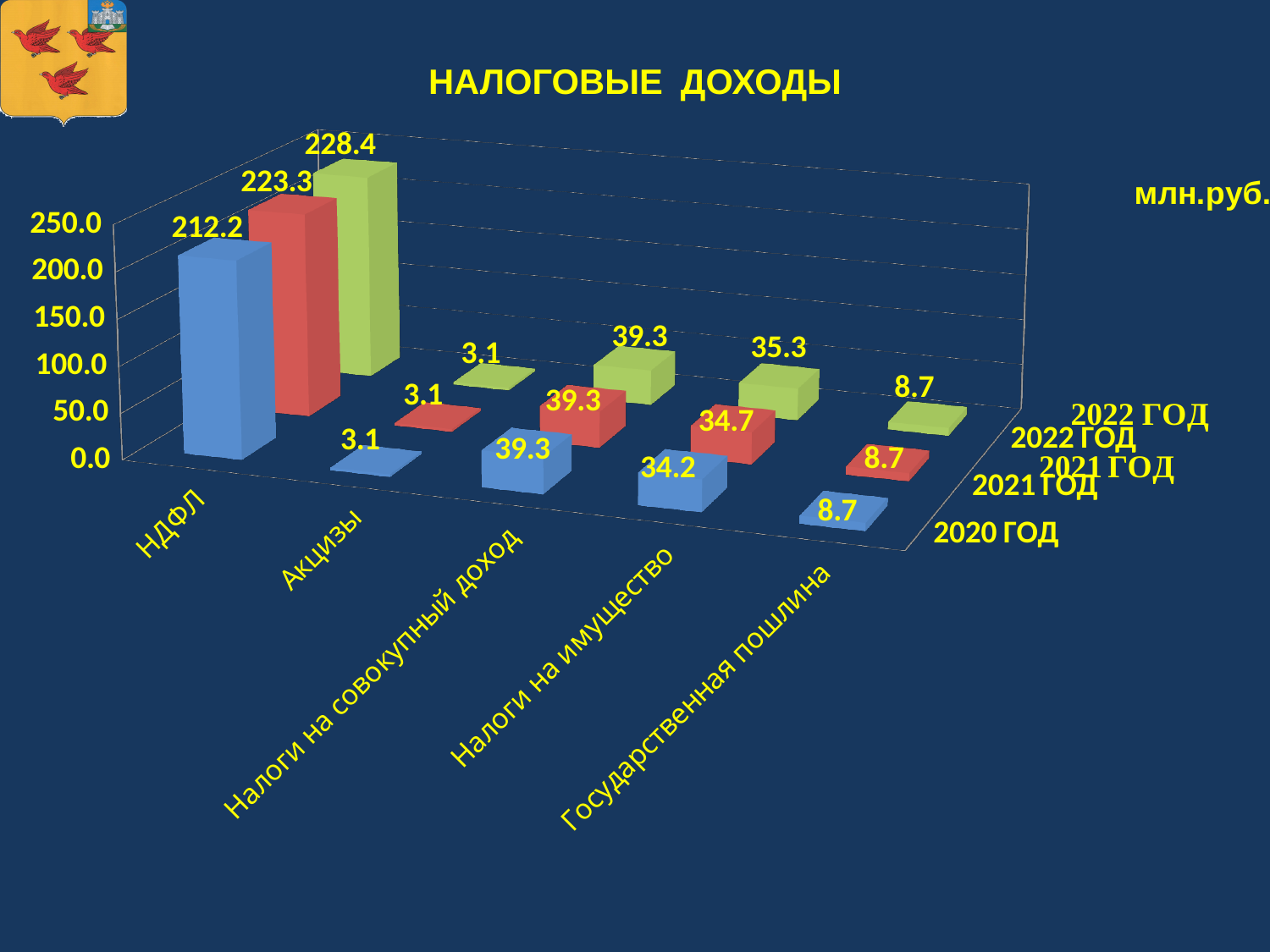
Which category has the lowest value in 2021 ГОД? Акцизы How many series (years) does the chart show? 3 What is the value for НДФЛ in 2020 ГОД? 212.2 What is the value for Налоги на имущество in 2021 ГОД? 34.7 What is the title of the chart? НАЛОГОВЫЕ ДОХОДЫ How many categories are shown on the x axis? 5 Is the value for НДФЛ in 2021 ГОД greater or less than 200.0? greater Which category has the highest value in 2022 ГОД? НДФЛ What is the value for НДФЛ in 2022 ГОД? 228.4 What is the value for Государственная пошлина in 2020 ГОД? 8.7 What is the difference between the НДФЛ values for 2022 ГОД and 2020 ГОД? 16.2 Which is larger: Налоги на совокупный доход in 2020 ГОД or Налоги на имущество in 2020 ГОД? Налоги на совокупный доход